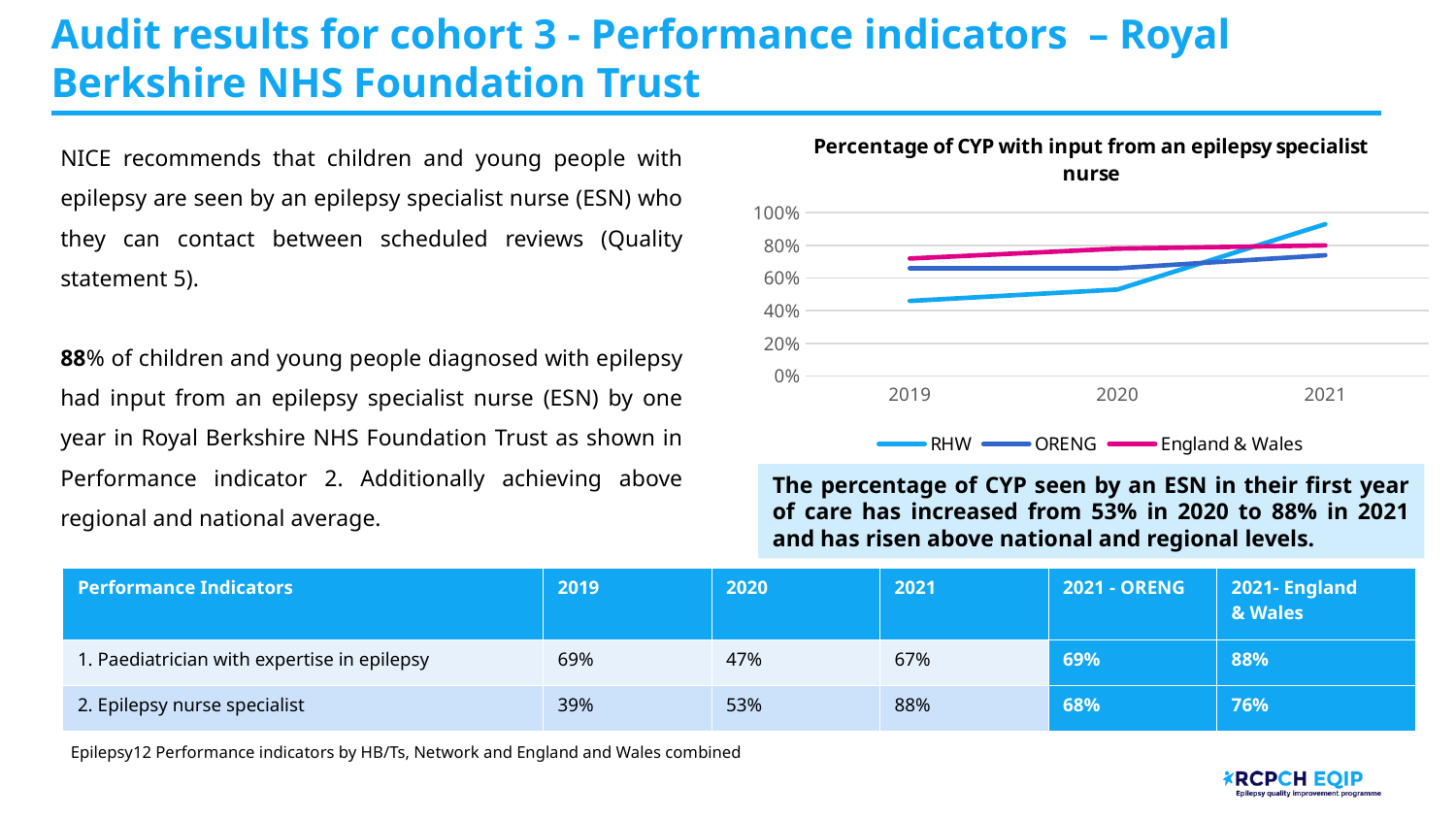
What is the RHW value for 2020 in the chart? 53% Is the England & Wales value for 2019 greater or less than 60%? greater What type of chart is shown on the slide? Line chart Which series has the highest value in 2021? RHW Which series has the lowest value in 2019? RHW Does the RHW line rise or fall from 2019 to 2021? Rise Is the RHW value for 2019 greater or less than 60%? less What is the title of the chart? Percentage of CYP with input from an epilepsy specialist nurse How many series does the chart legend list? 3 How many years are plotted along the x axis of the chart? 3